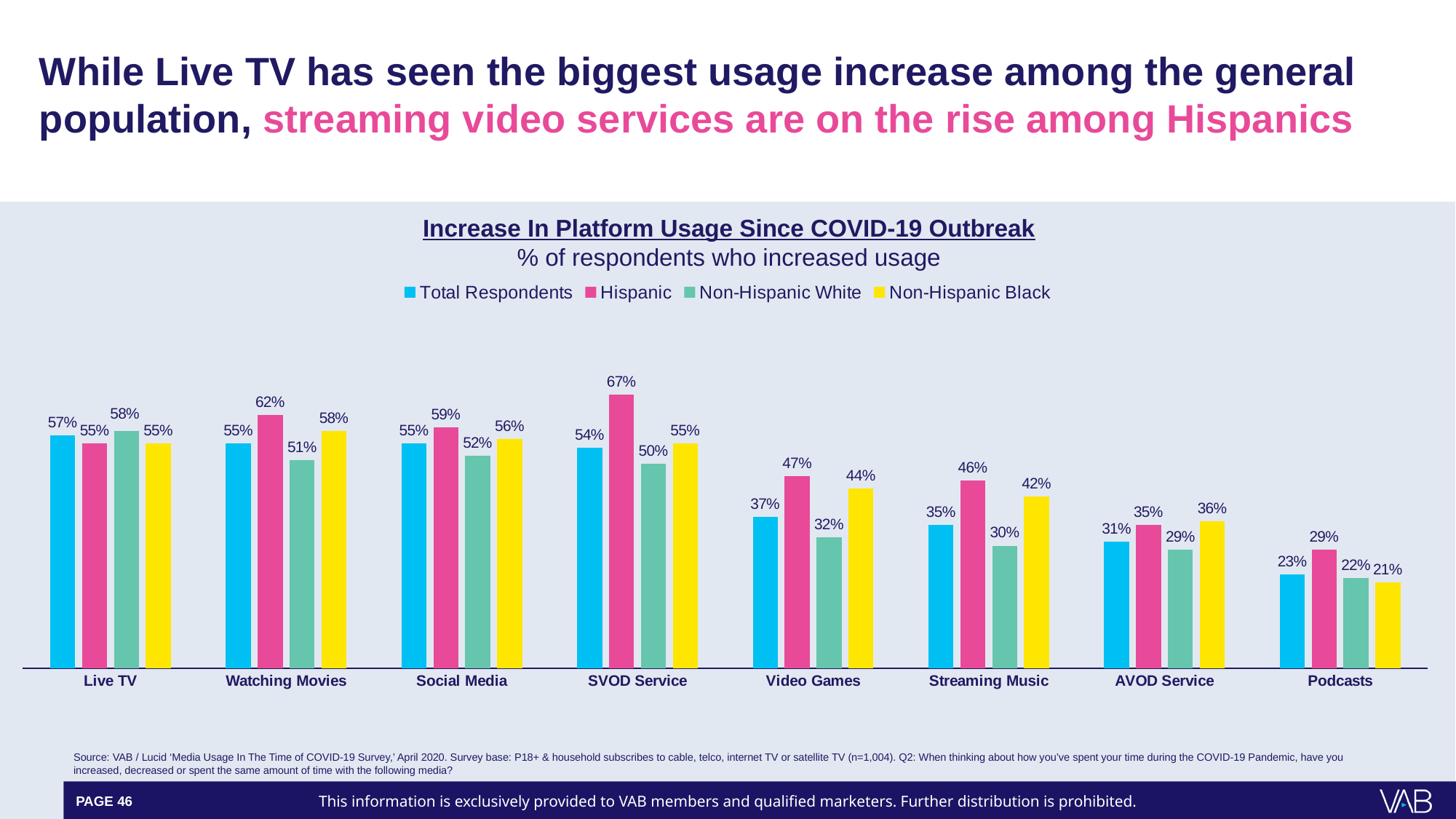
What is the value for Non-Hispanic Black for Streaming Music? 42% For Watching Movies, which is larger: the Hispanic value or the Non-Hispanic White value? Hispanic What is the value for Total Respondents for Live TV? 57% What is the difference between the Hispanic and Total Respondents values for SVOD Service? 13% What percentage of Hispanic respondents increased usage of SVOD Service? 67% How many platform categories are shown on the x axis? 8 What type of chart is shown on the slide? Bar chart Which series is shown in yellow in the legend? Non-Hispanic Black How many series does the legend list? 4 Which platform has the highest value for the Hispanic series? SVOD Service What is the value for Non-Hispanic White for Video Games? 32% Which platform has the lowest value for Total Respondents? Podcasts